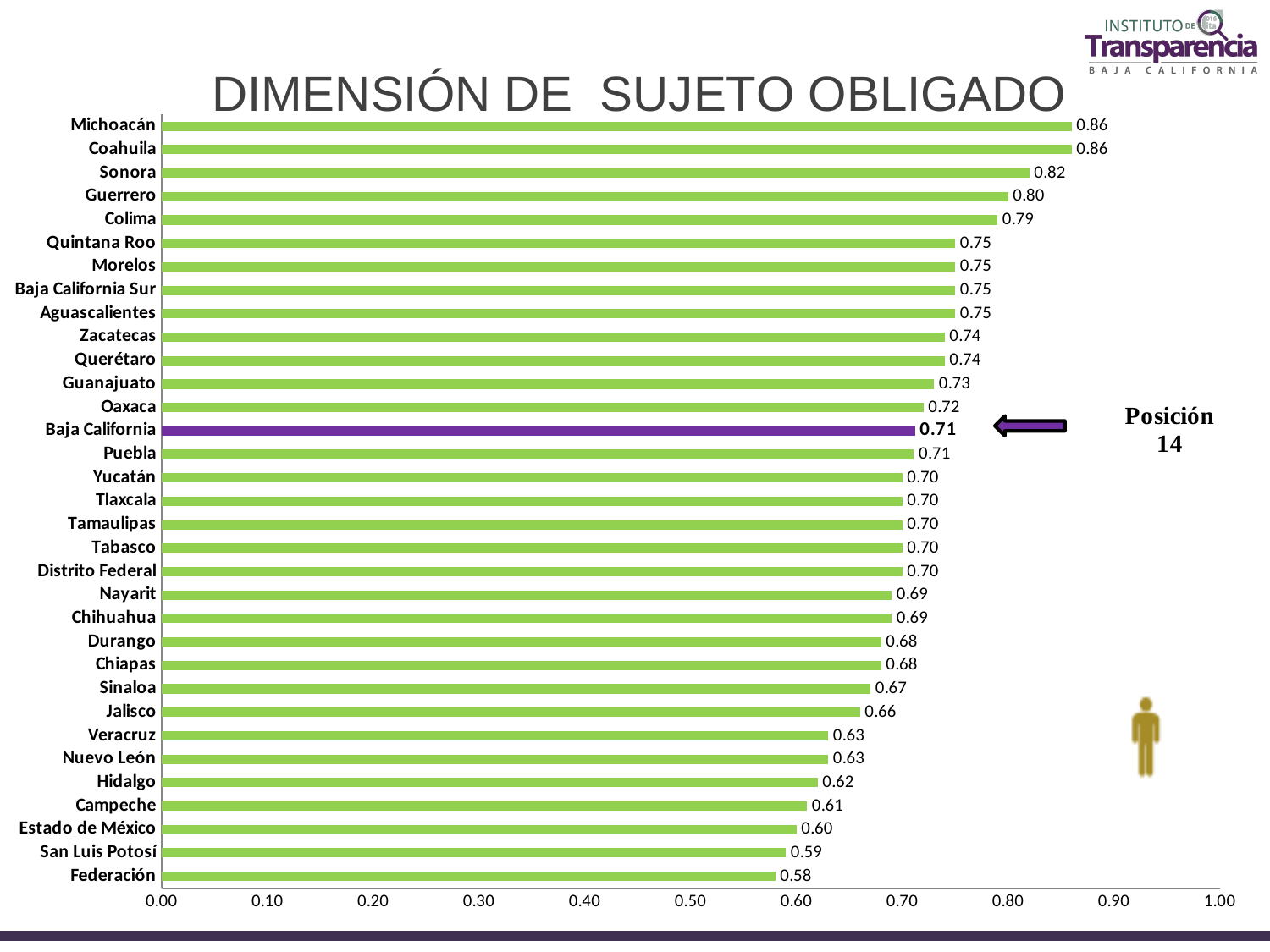
What is the value for Baja California? 0.71 What kind of chart is shown on the slide? Bar chart Which category has the lowest value? Federación Which is larger, the value for Guerrero or the value for Guanajuato? Guerrero What is the value for Sonora? 0.82 What is the difference between the values for Colima and Jalisco? 0.13 What is the value for Federación? 0.58 How many categories are shown in the chart? 33 What is the title of the chart? DIMENSIÓN DE SUJETO OBLIGADO Which is larger, the value for Hidalgo or the value for Sinaloa? Sinaloa What is the difference between the values for Michoacán and Baja California? 0.15 What is the value for Oaxaca? 0.72